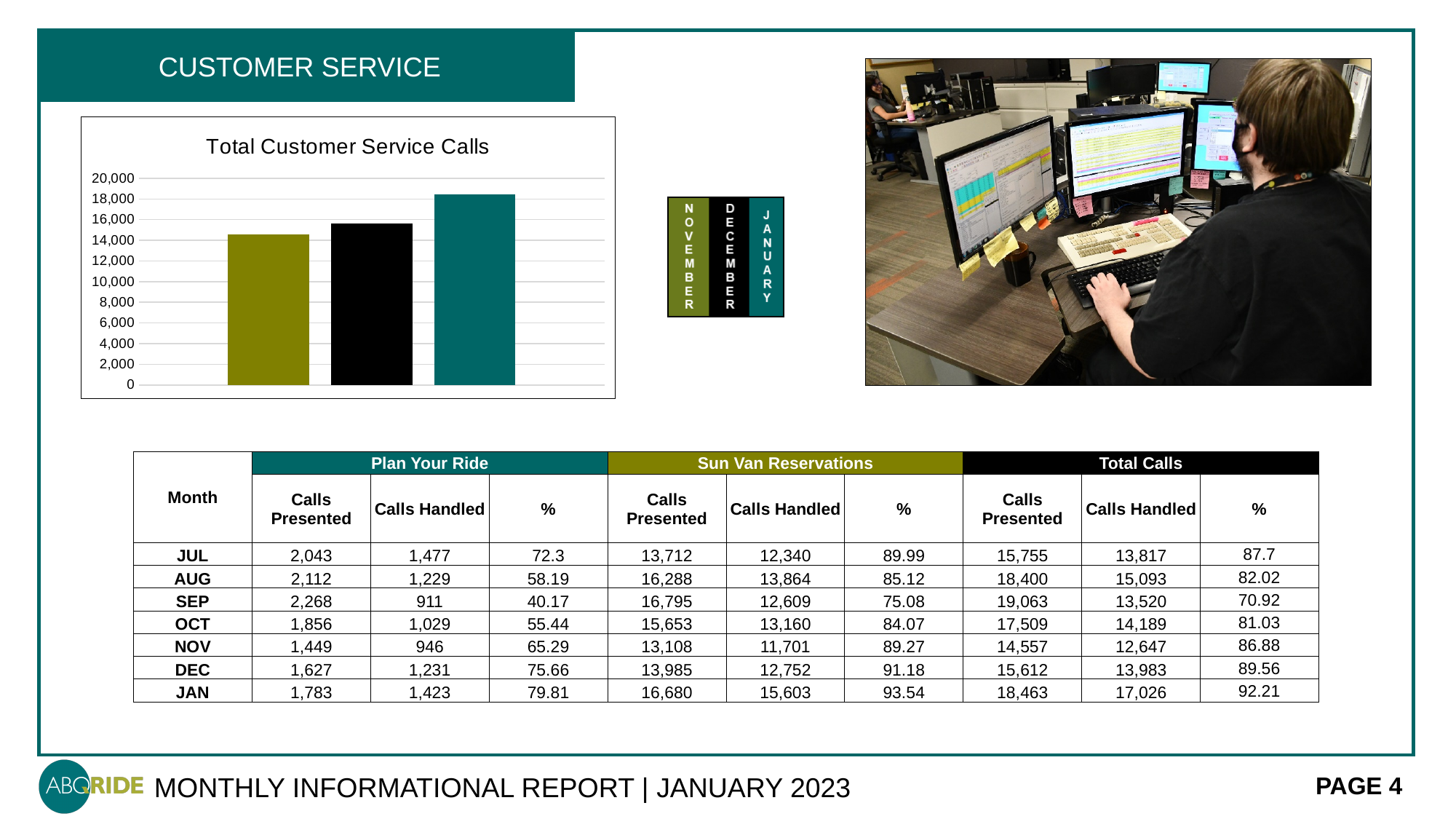
What colour is the bar for January in the "Total Customer Service Calls" chart? teal Which month has the highest bar in the "Total Customer Service Calls" chart? January How many entries does the legend next to the "Total Customer Service Calls" chart list? 3 How many bars are plotted in the "Total Customer Service Calls" chart? 3 In the "Total Customer Service Calls" chart, is the bar for November greater or less than 16,000? less What type of chart is "Total Customer Service Calls"? bar chart In the "Total Customer Service Calls" chart, is the bar for December greater or less than 14,000? greater Which month has the lowest bar in the "Total Customer Service Calls" chart? November Do the bars in the "Total Customer Service Calls" chart rise or fall from November to January? rise In the "Total Customer Service Calls" chart, which bar is taller, December or January? January In the "Total Customer Service Calls" chart, is the bar for January greater or less than 18,000? greater What is the title of the bar chart on the slide? Total Customer Service Calls